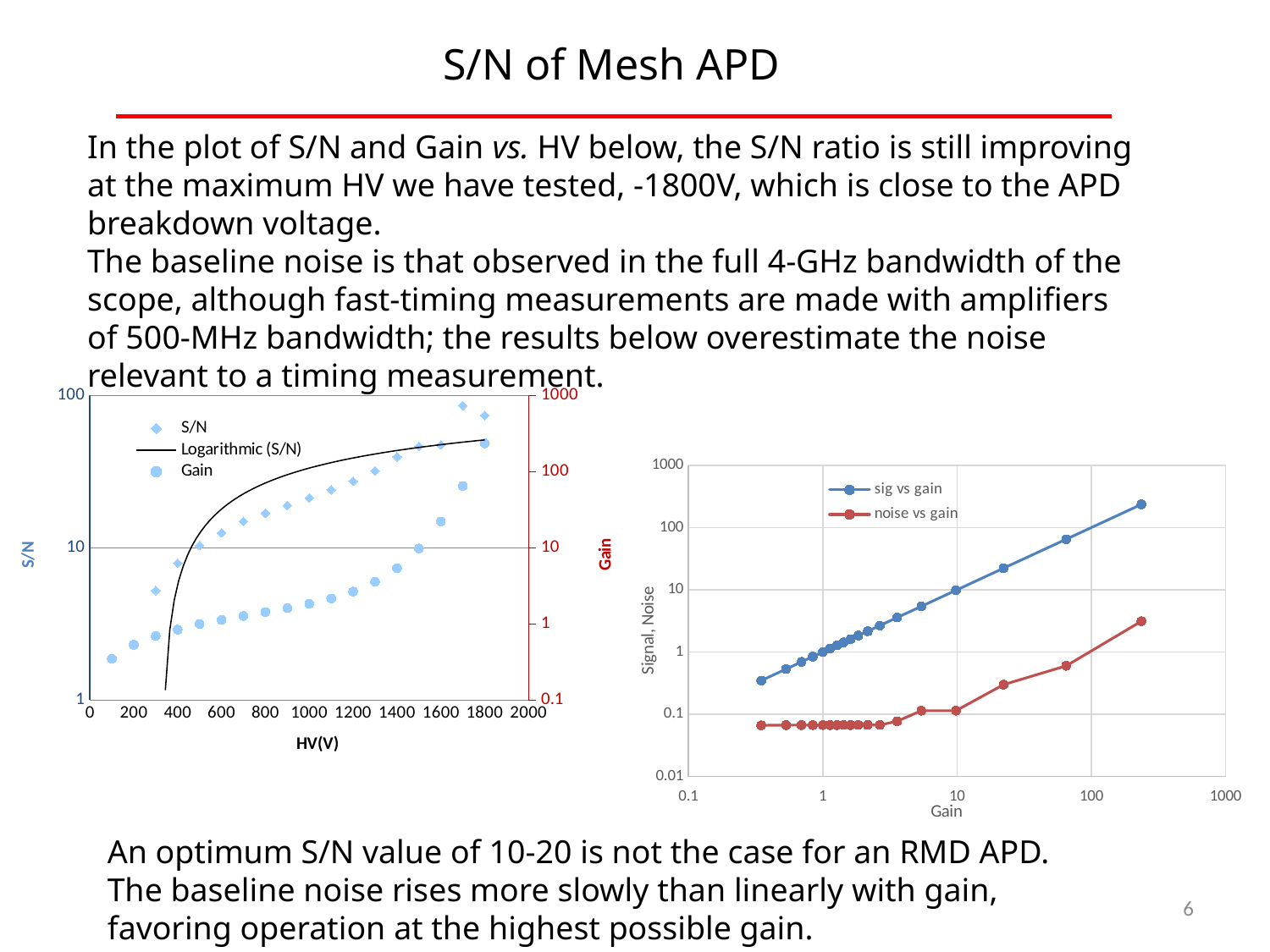
In the left chart, is the Gain value at 1800 V greater or less than 100? greater What is the x-axis title of the left chart? HV(V) In the right chart, at a gain of 10, which series has the larger value, sig vs gain or noise vs gain? sig vs gain In the left chart, is the S/N value at 1800 V greater or less than 10? greater How many series does the legend of the right chart list? 2 How many entries does the legend of the left chart list? 3 In the left chart, does S/N rise or fall as HV increases? rise What kind of chart is the right chart (Signal, Noise vs Gain)? line chart In the right chart, does the noise vs gain series rise or fall as gain increases? rise In the right chart, is the noise vs gain value at a gain of 1 greater or less than 0.1? less What kind of chart is the left chart (S/N and Gain vs HV)? scatter chart